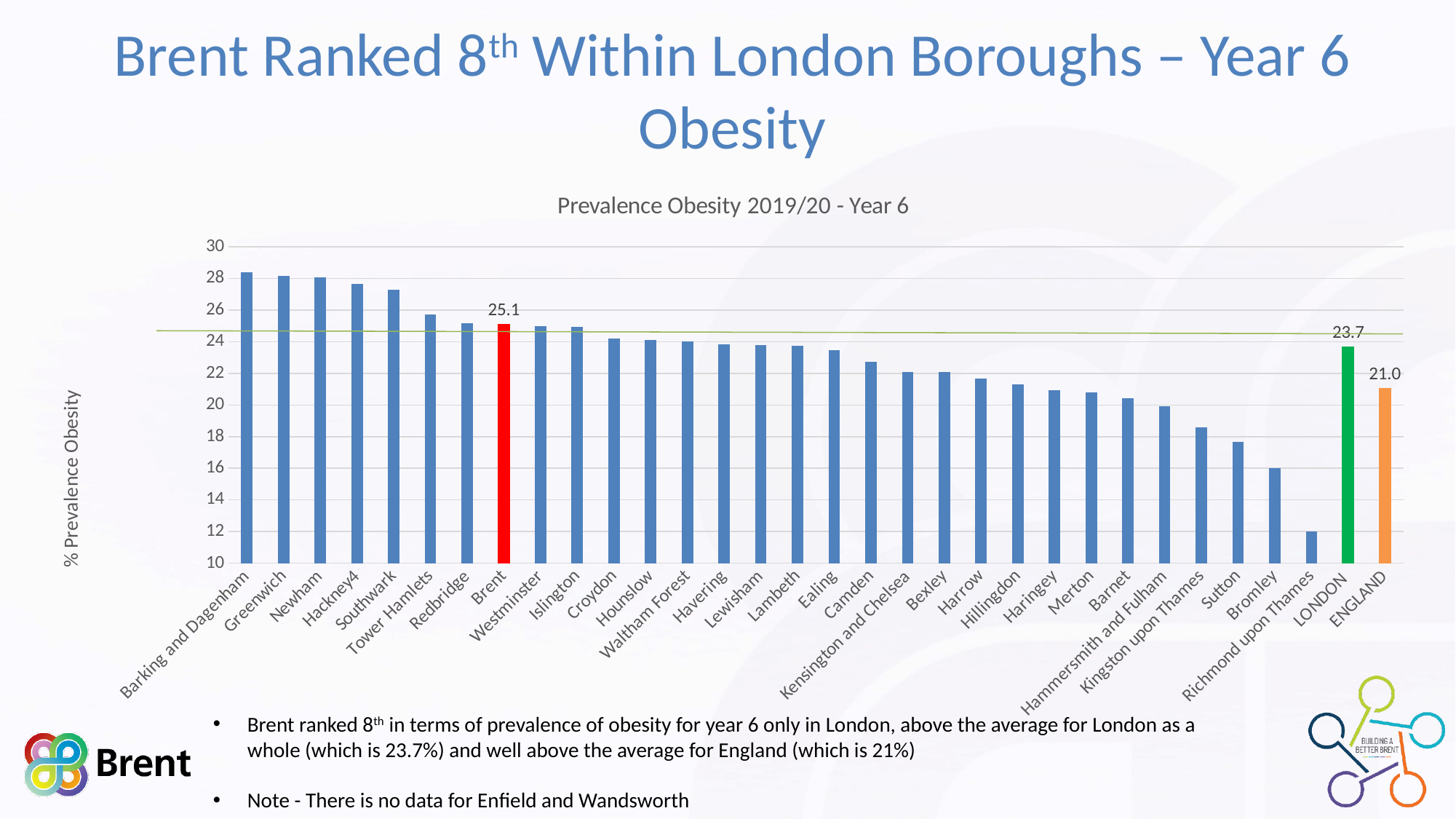
What is the title of the chart? Prevalence Obesity 2019/20 - Year 6 Which category has the lowest value in the chart? Richmond upon Thames Is the value for Bromley greater or less than 18? less Is the value for Barking and Dagenham greater or less than 26? greater How much higher is Brent's value than the LONDON value? 1.4 Is the value for Richmond upon Thames greater or less than 14? less What is the value shown for ENGLAND? 21.0 What is the value for Brent in the Prevalence Obesity 2019/20 - Year 6 chart? 25.1 What kind of chart is shown on the slide? bar chart Which is larger, the value for Brent or the value for LONDON? Brent What is the difference between the Brent value and the ENGLAND value? 4.1 What is the value shown for LONDON? 23.7